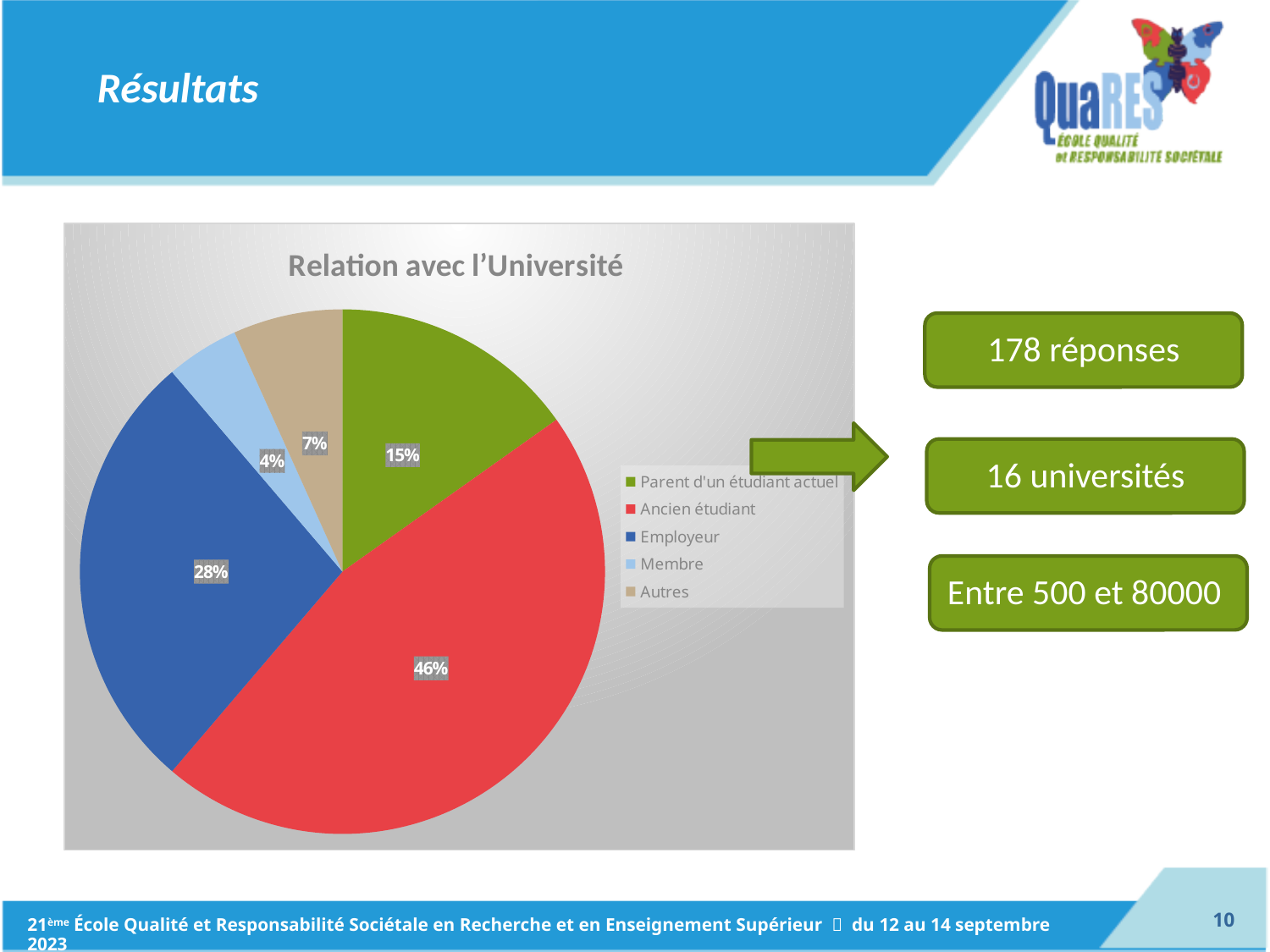
What share of the pie does 'Parent d'un étudiant actuel' represent? 15% What share of the pie does 'Ancien étudiant' represent? 46% What is the difference in percentage points between 'Ancien étudiant' and 'Employeur'? 18 Which category has the largest slice of the pie? Ancien étudiant Which is larger, the share for 'Autres' or the share for 'Membre'? Autres How many categories does the pie chart show? 5 Which category has the smallest slice of the pie? Membre What is the title of the chart? Relation avec l'Université What share of the pie does 'Autres' represent? 7% What kind of chart is shown on the slide? pie chart